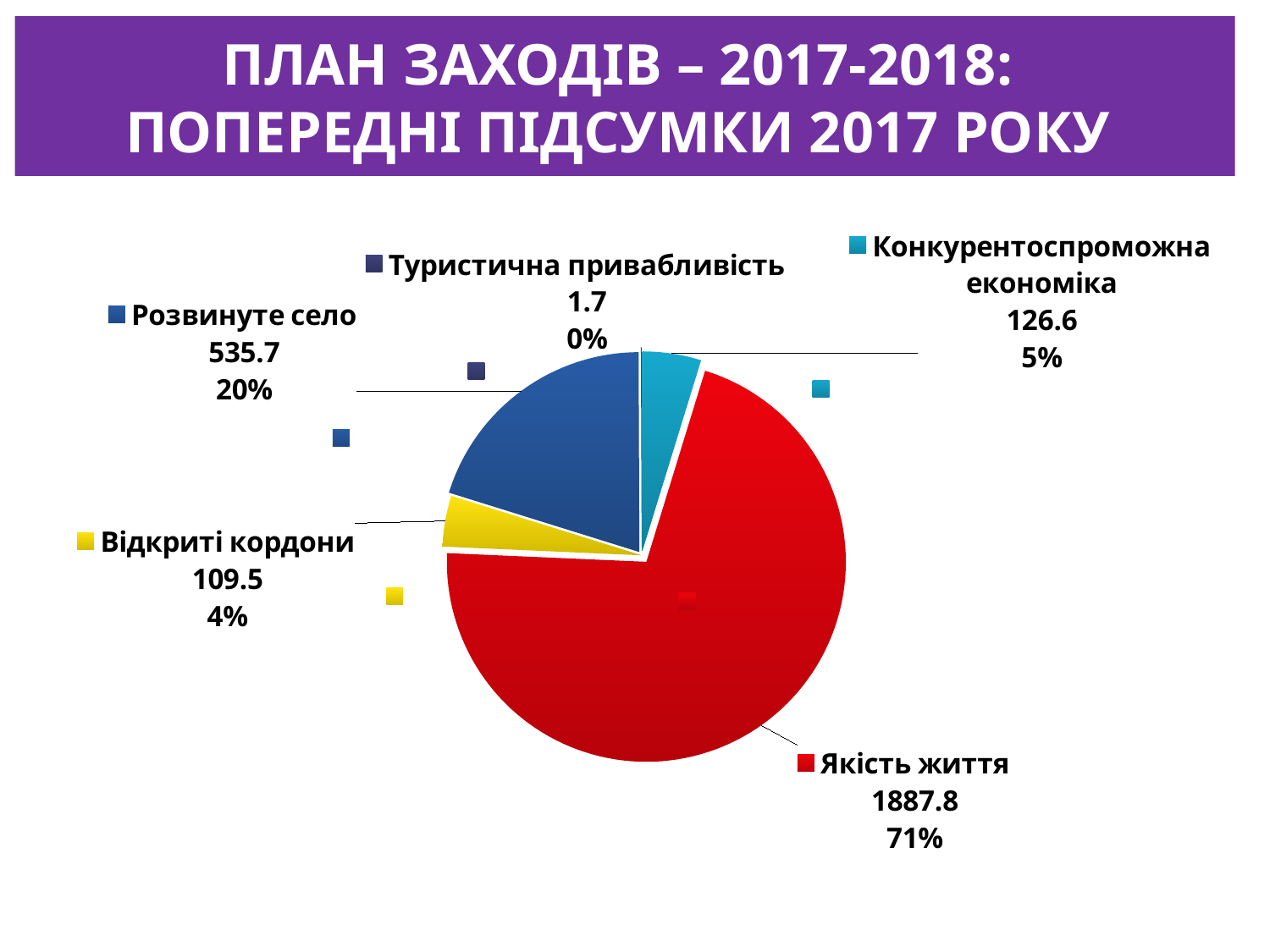
What is the value shown for Якість життя? 1887.8 Which is larger, the value for Розвинуте село or the value for Конкурентоспроможна економіка? Розвинуте село How many categories are shown in the pie chart? 5 What is the difference between the values for Конкурентоспроможна економіка and Відкриті кордони? 17.1 What percentage share is shown for Відкриті кордони? 4% What kind of chart is shown on the slide? Pie chart What is the value shown for Розвинуте село? 535.7 What percentage share is shown for Конкурентоспроможна економіка? 5% Which category has the smallest slice of the pie? Туристична привабливість What colour is the slice for Відкриті кордони? Yellow Which category has the largest slice of the pie? Якість життя What is the difference between the values for Якість життя and Розвинуте село? 1352.1